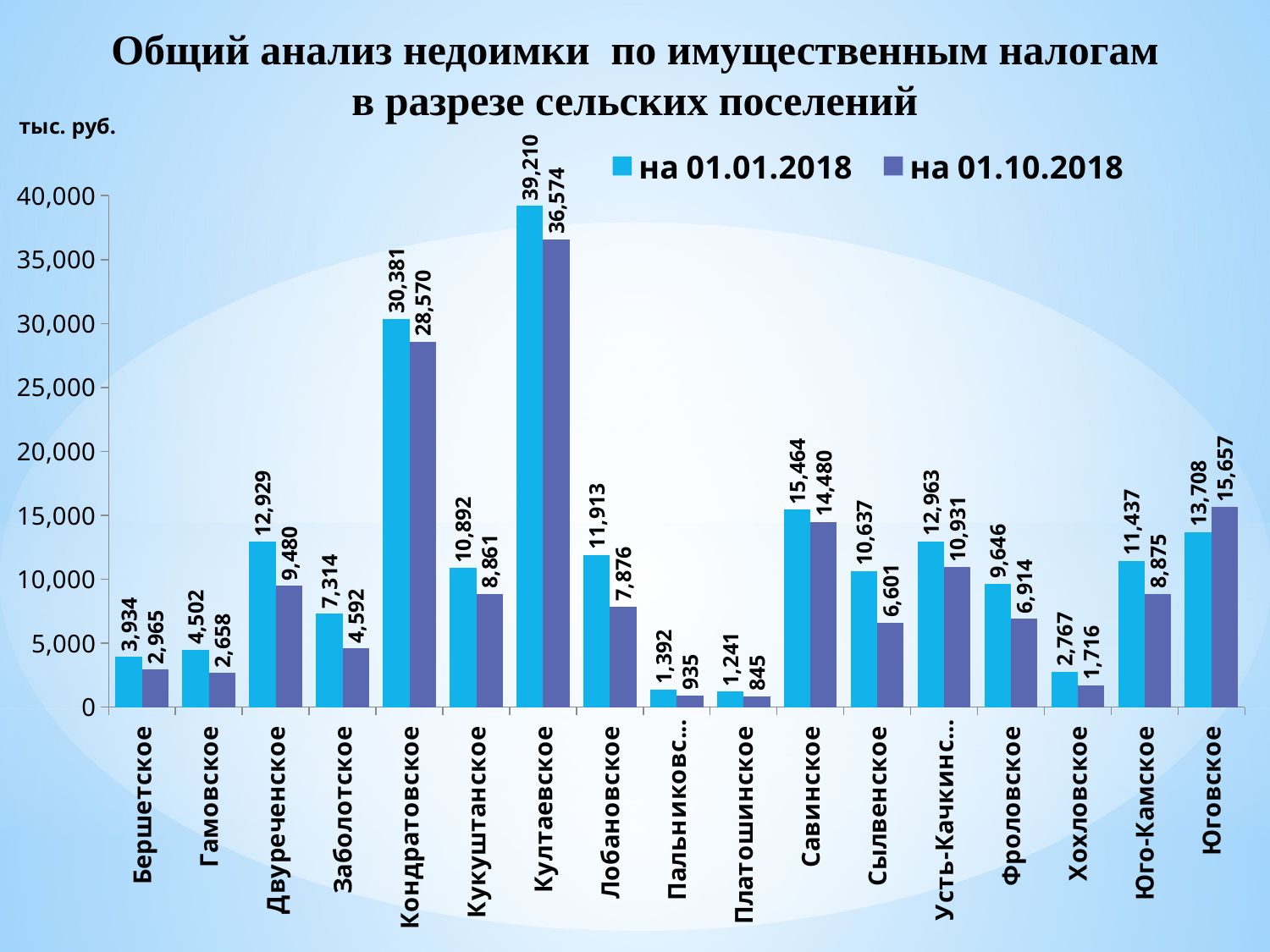
What is the difference between the 01.01.2018 and 01.10.2018 values for Лобановское? 4,037 Which is larger for Юговское: the value on 01.01.2018 or the value on 01.10.2018? на 01.10.2018 What is the value for Кондратовское on 01.10.2018 (на 01.10.2018)? 28,570 Is the value for Савинское on 01.01.2018 greater or less than 15,000? greater What type of chart is shown on the slide? bar chart How many series does the legend list? 2 Which settlement has the lowest value on 01.10.2018 (на 01.10.2018)? Платошинское Which settlement has the highest value on 01.01.2018 (на 01.01.2018)? Култаевское What is the value for Юговское on 01.10.2018 (на 01.10.2018)? 15,657 How many settlements (categories) are shown on the x axis? 17 What unit is indicated above the vertical axis? тыс. руб. What is the value for Култаевское on 01.01.2018 (на 01.01.2018)? 39,210